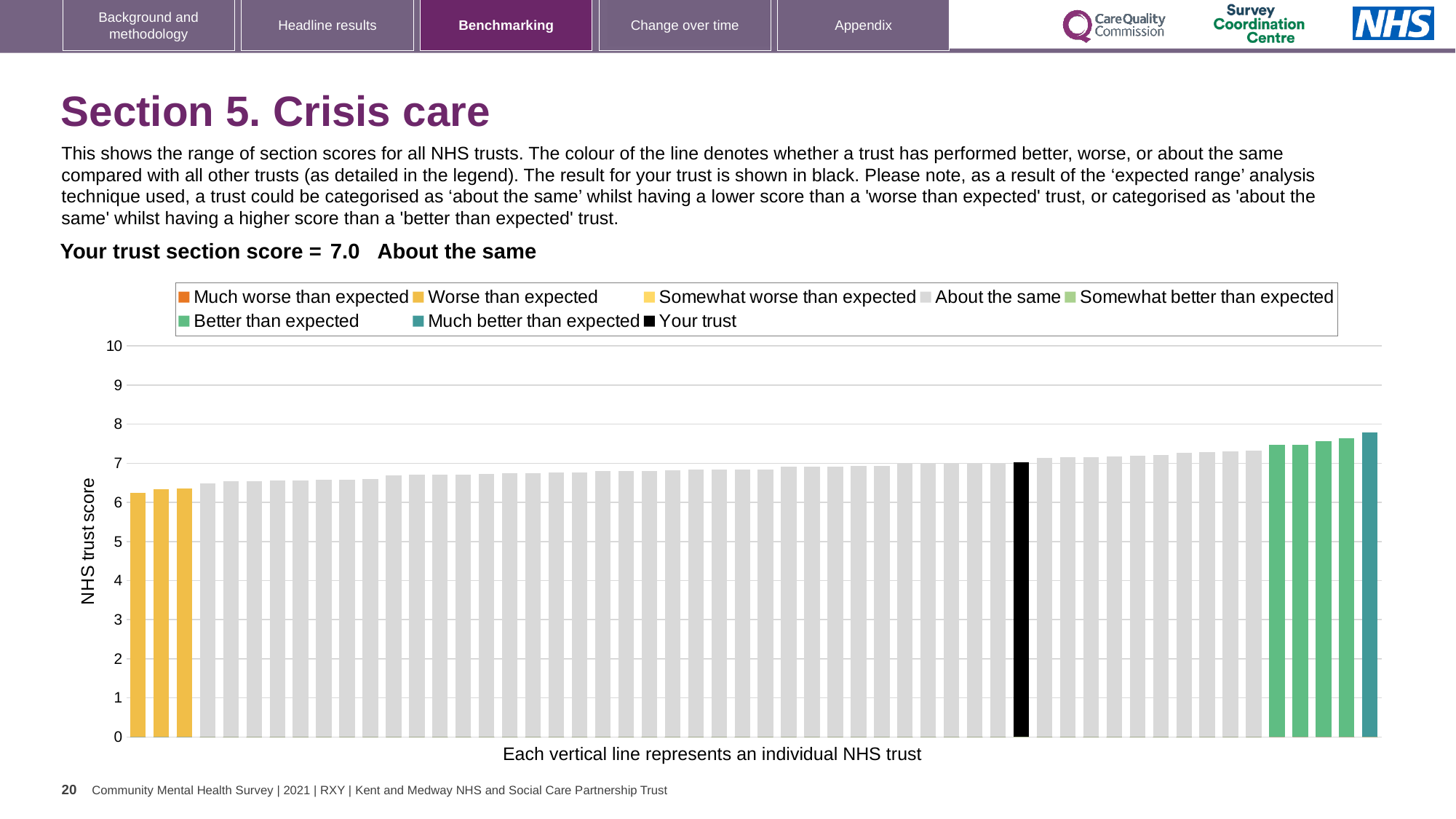
Do the bar values rise or fall from left to right along the x axis? rise What kind of chart is shown on the slide? bar chart What is the section score for your trust shown on the slide? 7.0 Is the value for your trust (black bar) greater or less than 5? greater How many bars are coloured in the 'Worse than expected' yellow colour? 3 How many bars are coloured in the 'Better than expected' green colour? 4 Is the value of the shortest bar greater or less than 6? greater Is the value of the tallest bar greater or less than 8? less How many entries does the chart legend list? 8 What is the label on the vertical axis of the chart? NHS trust score Which is larger, the leftmost bar or the rightmost bar? the rightmost bar What colour is the bar representing your trust? black